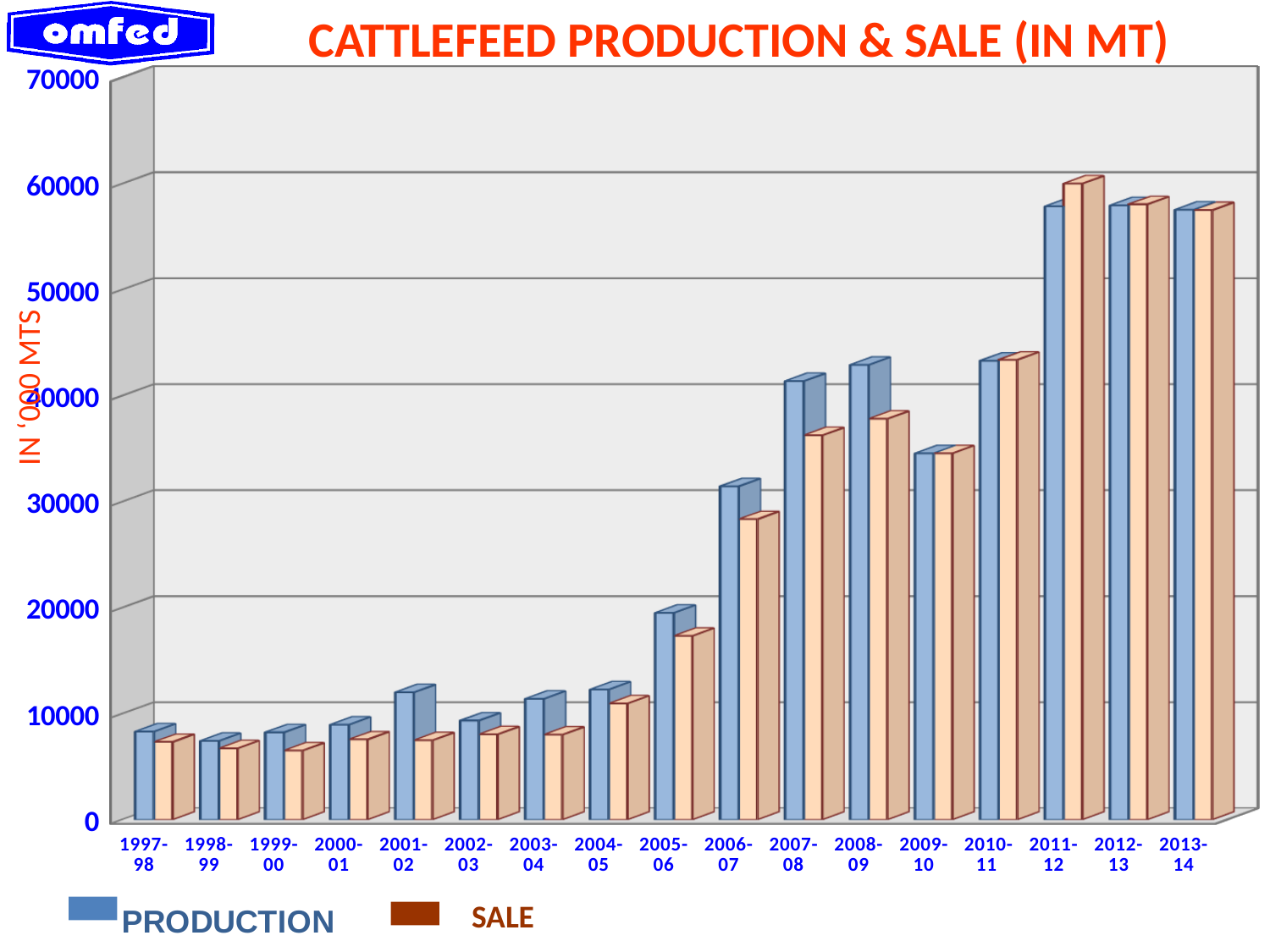
Is the PRODUCTION value for 2001-02 greater or less than 10000? greater Is the SALE value for 2007-08 greater or less than 40000? less Is the PRODUCTION value for 2007-08 greater or less than 40000? greater Overall, does PRODUCTION rise or fall from 1997-98 to 2013-14? rise What is the title of the chart? CATTLEFEED PRODUCTION & SALE (IN MT) For 2008-09, which is larger, PRODUCTION or SALE? PRODUCTION What kind of chart is shown on the slide? bar chart How many year categories are shown on the x axis? 17 How many series does the legend list? 2